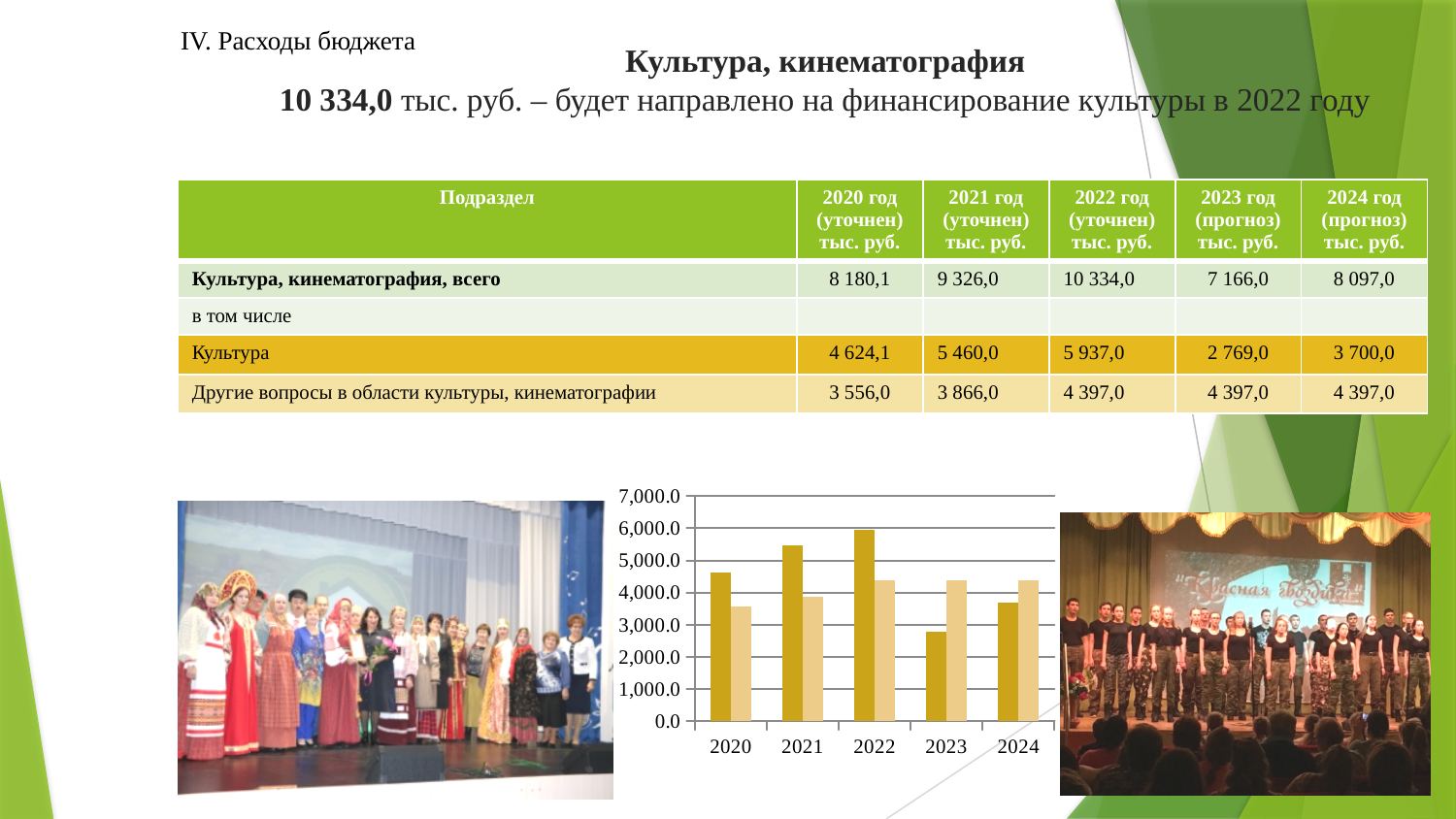
In the bar chart, is the lighter bar for 2020 greater or less than 4,000.0? less How many bars are plotted for each year in the bar chart? 2 In the bar chart, for 2021, which bar is taller: the darker bar or the lighter bar? the darker bar What kind of chart is shown at the bottom of the slide? bar chart In the bar chart, is the darker bar for 2022 greater or less than 5,000.0? greater In the bar chart, do the darker bars rise or fall from 2020 to 2022? rise What is the highest value shown on the y axis of the bar chart? 7,000.0 In the bar chart, for 2023, which bar is taller: the darker bar or the lighter bar? the lighter bar In the bar chart, is the darker bar for 2023 greater or less than 3,000.0? less How many years are shown on the x axis of the bar chart? 5 In the bar chart, which year has the tallest darker (left) bar? 2022 In the bar chart, which year has the shortest darker (left) bar? 2023